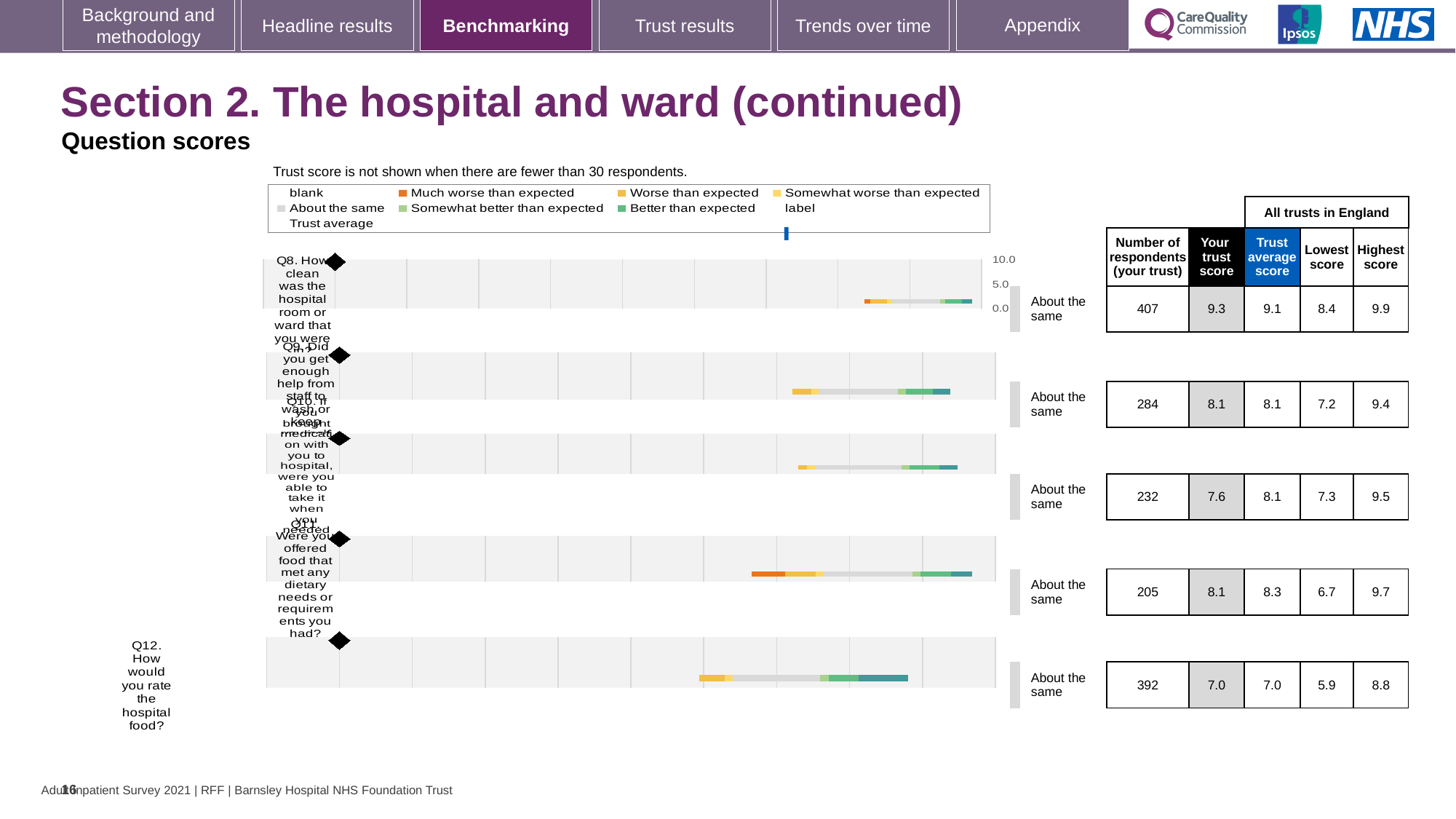
How many respondents from your trust answered Q8 (how clean was the hospital room or ward)? 407 What is your trust score for Q12 (how would you rate the hospital food)? 7.0 What is the trust average score for Q11 (were you offered food that met any dietary needs or requirements you had)? 8.3 Which question has the lowest 'Your trust score' on this slide? Q12 How many questions are shown on this slide? 5 Which question had more respondents from your trust, Q8 or Q12? Q8 Which question has the highest 'Your trust score' on this slide? Q8 What kind of chart is used to show the question scores? Bar chart For Q10, what is the difference between the trust average score and your trust score? 0.5 What is the lowest score across all trusts in England for Q10 (if you brought medication with you to hospital, were you able to take it when you needed to)? 7.3 What benchmark category is shown for Q9 (did you get enough help from staff to wash or keep yourself clean)? About the same What is the highest score across all trusts in England for Q9 (did you get enough help from staff to wash or keep yourself clean)? 9.4